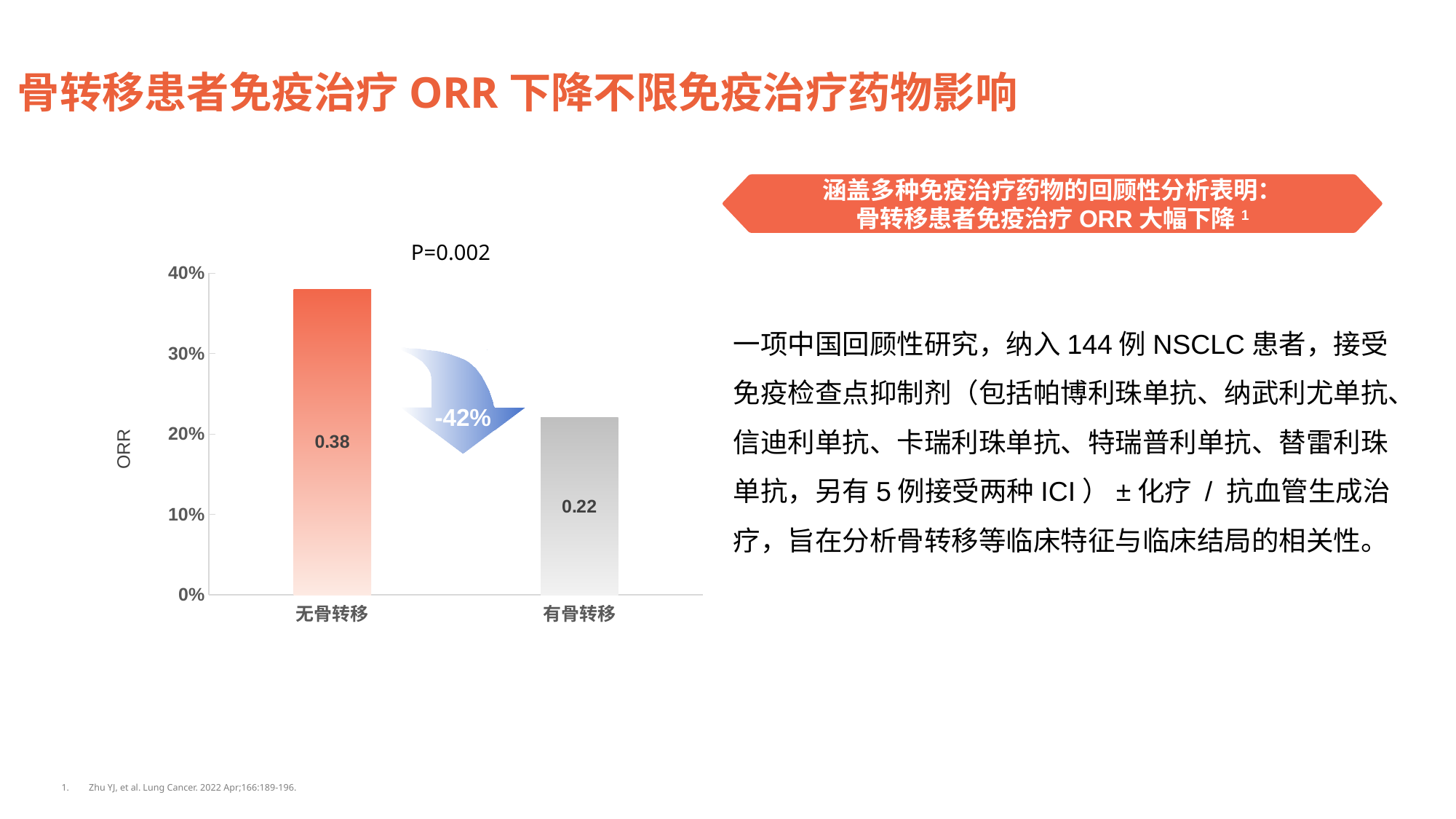
Which category has the higher ORR? 无骨转移 Which category has the lower ORR? 有骨转移 What is the difference between the ORR values for 无骨转移 and 有骨转移? 0.16 What is the label of the y axis of the chart? ORR Is the value for 有骨转移 greater or less than 30%? less What P value is printed above the chart? P=0.002 What is the ORR value shown for 无骨转移? 0.38 Is the value for 无骨转移 greater or less than 30%? greater Is the ORR for 无骨转移 larger or smaller than the ORR for 有骨转移? larger What kind of chart is shown on the slide? bar chart What is the ORR value shown for 有骨转移? 0.22 How many categories are shown on the x axis of the chart? 2